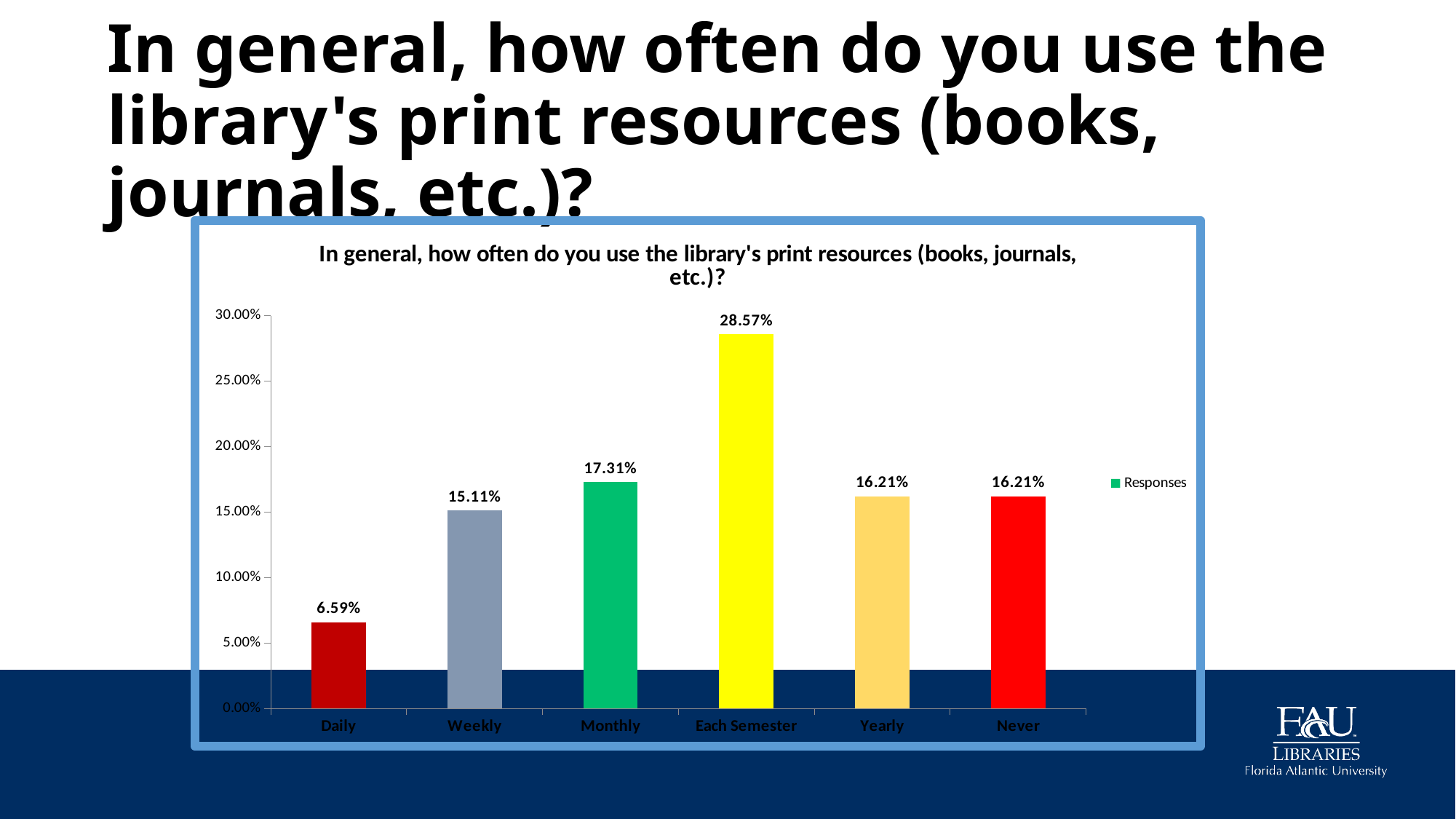
What percentage of responses is shown for Each Semester? 28.57% What percentage of responses is shown for Monthly? 17.31% Which is larger, the value for Monthly or the value for Weekly? Monthly What kind of chart is shown on the slide? bar chart What percentage of responses is shown for Daily? 6.59% What is the name of the series listed in the legend? Responses Which category has the lowest percentage of responses? Daily Which category has the highest percentage of responses? Each Semester How many categories are shown on the x axis? 6 Is the value for Weekly greater or less than 20.00%? less What is the difference between the Each Semester and Weekly percentages? 13.46% How many series does the legend list? 1